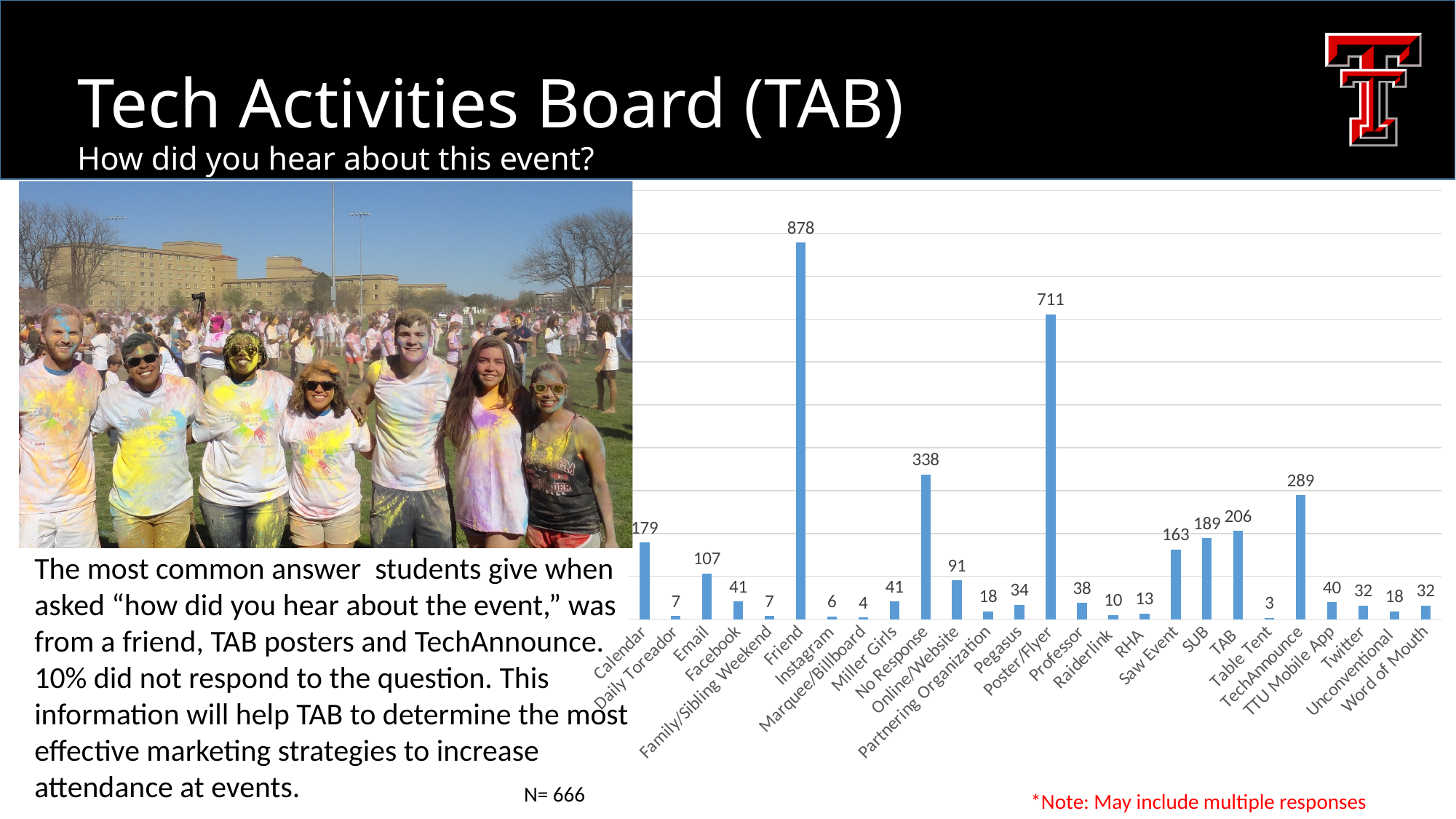
What is the value for Friend? 878 What is the value for No Response? 338 Which is larger, the value for SUB or the value for TAB? TAB What is the difference between the values for Calendar and Email? 72 What is the value for TechAnnounce? 289 What is the value for Poster/Flyer? 711 What kind of chart is shown on the slide? Bar chart How many categories are shown on the x axis? 26 Which category has the lowest value? Table Tent What is the value for Saw Event? 163 Which category has the highest value? Friend What is the difference between the values for Friend and Poster/Flyer? 167